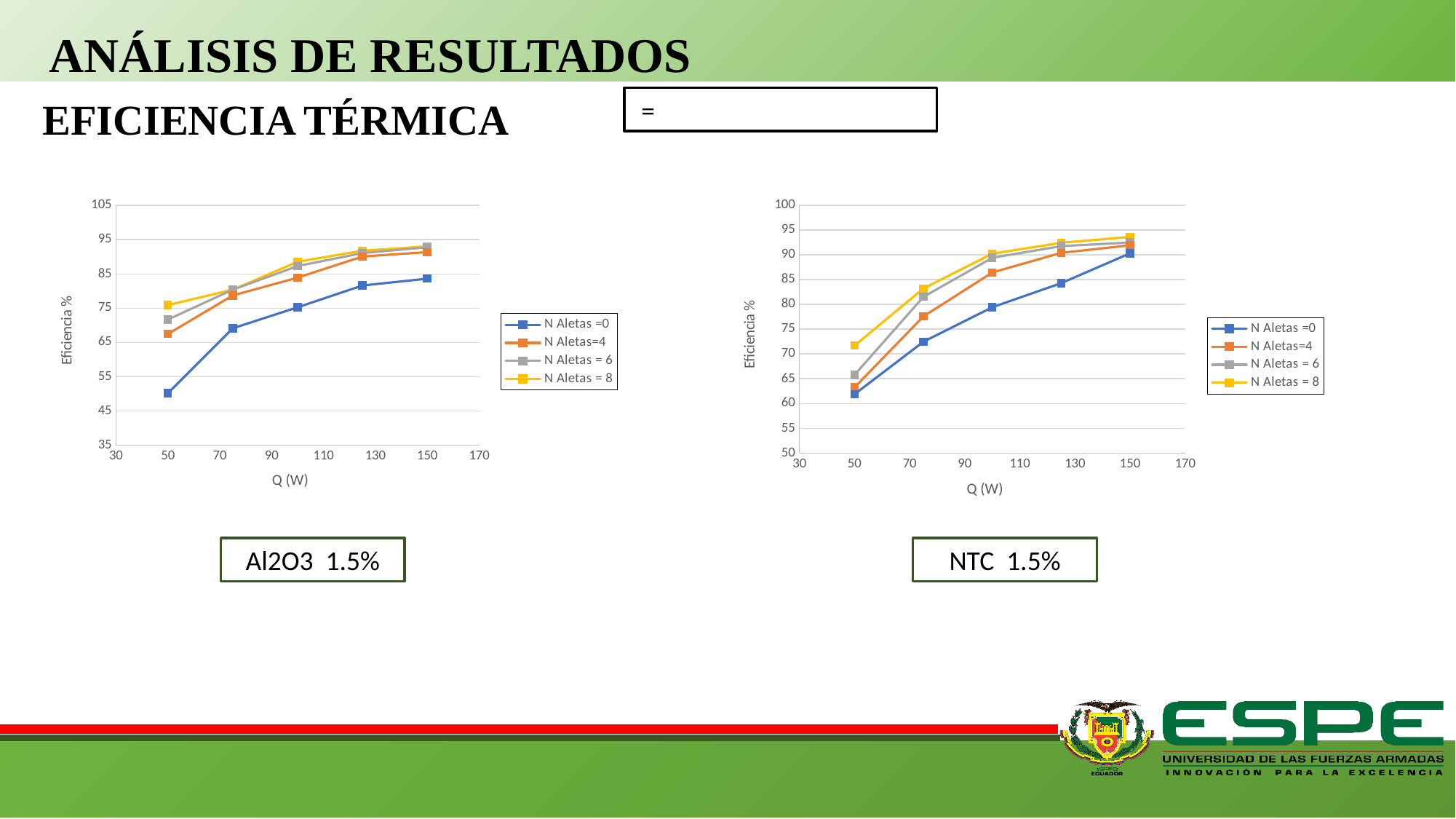
What is the x-axis title of the NTC 1.5% chart? Q (W) In the NTC 1.5% chart, is the efficiency for N Aletas = 8 at Q = 150 W greater or less than 85? greater How many series does the legend of the NTC 1.5% chart list? 4 In the NTC 1.5% chart, at Q = 100 W, which is larger: the efficiency for N Aletas =0 or for N Aletas = 8? N Aletas = 8 In the Al2O3 1.5% chart, at Q = 50 W, which is larger: the efficiency for N Aletas=4 or for N Aletas =0? N Aletas=4 What is the y-axis title of the Al2O3 1.5% chart? Eficiencia % In the Al2O3 1.5% chart, how many data points does the N Aletas =0 series have? 5 In the Al2O3 1.5% chart, which series has the lowest efficiency at Q = 50 W? N Aletas =0 In the NTC 1.5% chart, which series has the highest efficiency at Q = 50 W? N Aletas = 8 In the Al2O3 1.5% chart, is the efficiency for N Aletas =0 at Q = 50 W greater or less than 65? less In the NTC 1.5% chart, does the efficiency for N Aletas =0 rise or fall as Q (W) increases? Rises What type of chart is the Al2O3 1.5% chart on the left? Line chart